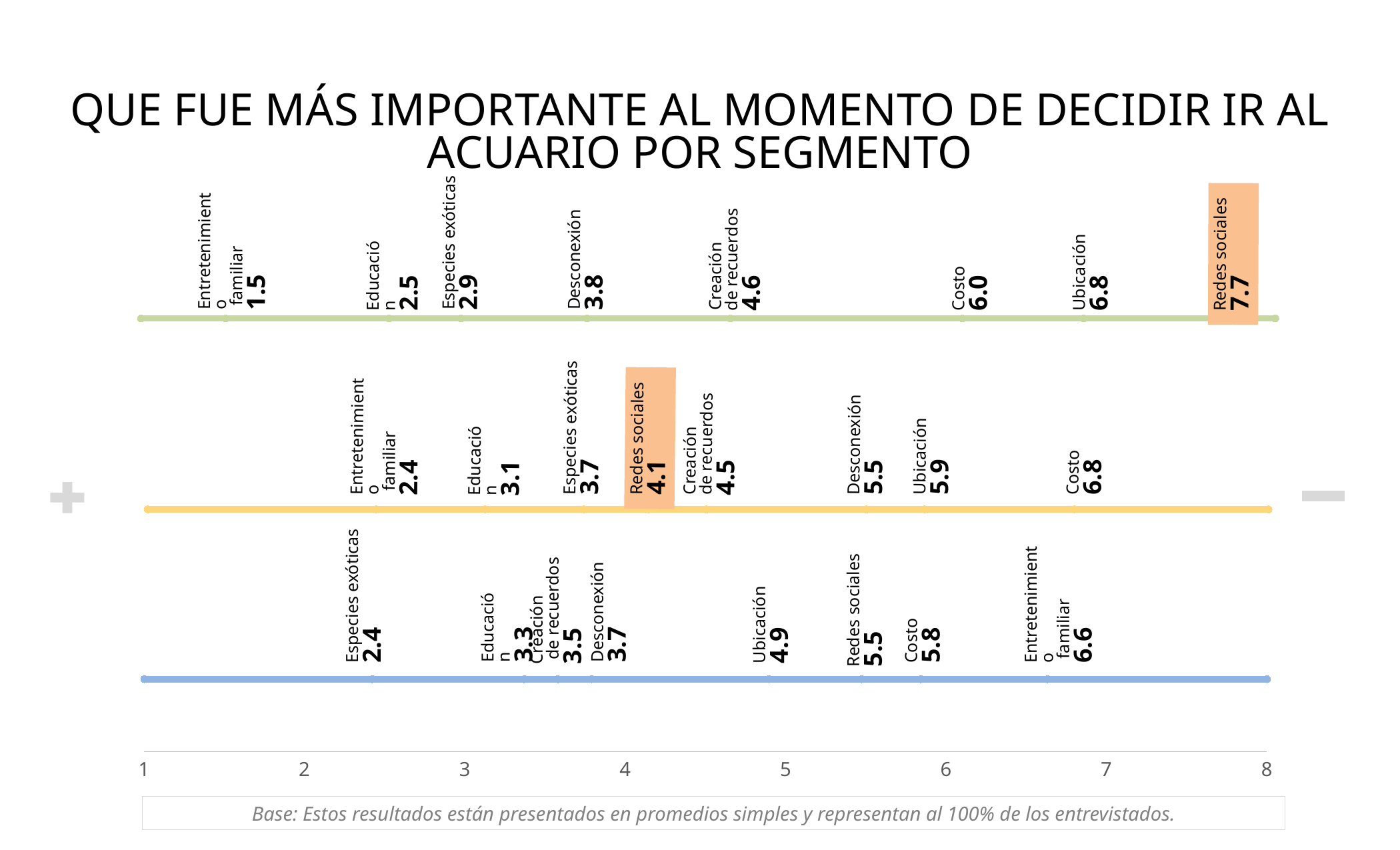
Which category is highlighted with an orange box on the middle (yellow) line? Redes sociales On the top (green) line, which category has the lowest value? Entretenimiento familiar On the bottom (blue) line, what is the value for Entretenimiento familiar? 6.6 On the middle (yellow) line, which is larger, Educación or Especies exóticas? Especies exóticas On the top (green) line, what is the value for Redes sociales? 7.7 On the top (green) line, what is the difference between Redes sociales and Ubicación? 0.9 On the bottom (blue) line, which category has the lowest value? Especies exóticas On the bottom (blue) line, what is the difference between Costo and Redes sociales? 0.3 How many categories are plotted on the top (green) line? 8 On the middle (yellow) line, which category has the highest value? Costo On the top (green) line, what is the value for Costo? 6.0 On the middle (yellow) line, what is the value for Desconexión? 5.5